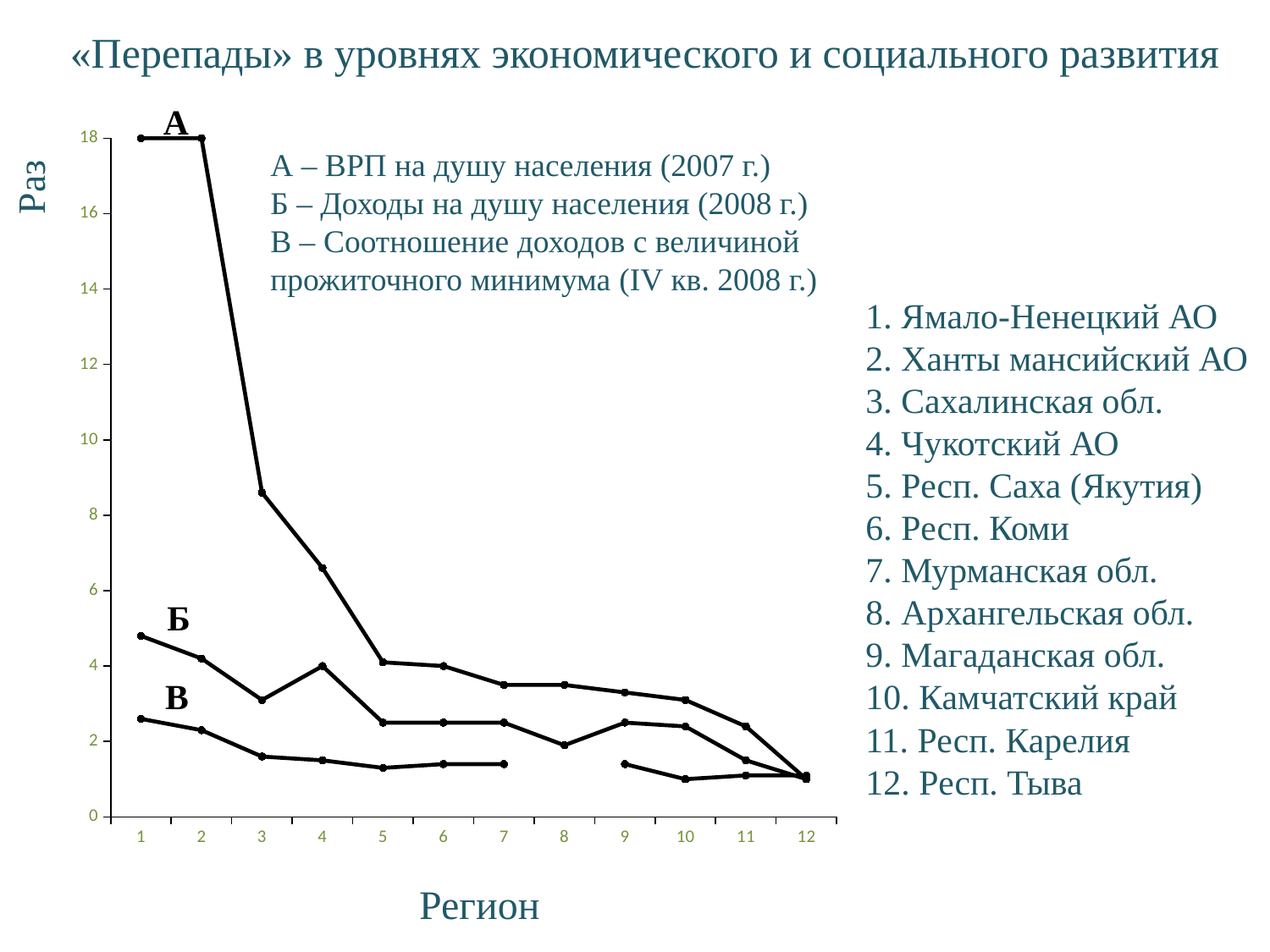
How many series are plotted on the chart? 3 What kind of chart is shown on the slide? line chart Which series has the highest value at region 1? А How many regions are shown along the x axis? 12 What is the value of series А for region 1? 18 At region 3, which series has the larger value, А or Б? А Is the value of series А for region 4 greater or less than 8? less Does series А rise or fall from region 1 to region 12? fall Is the value of series Б for region 1 greater or less than 4? greater Is the value of series В for region 3 greater or less than 2? less What is the label of the x axis? Регион